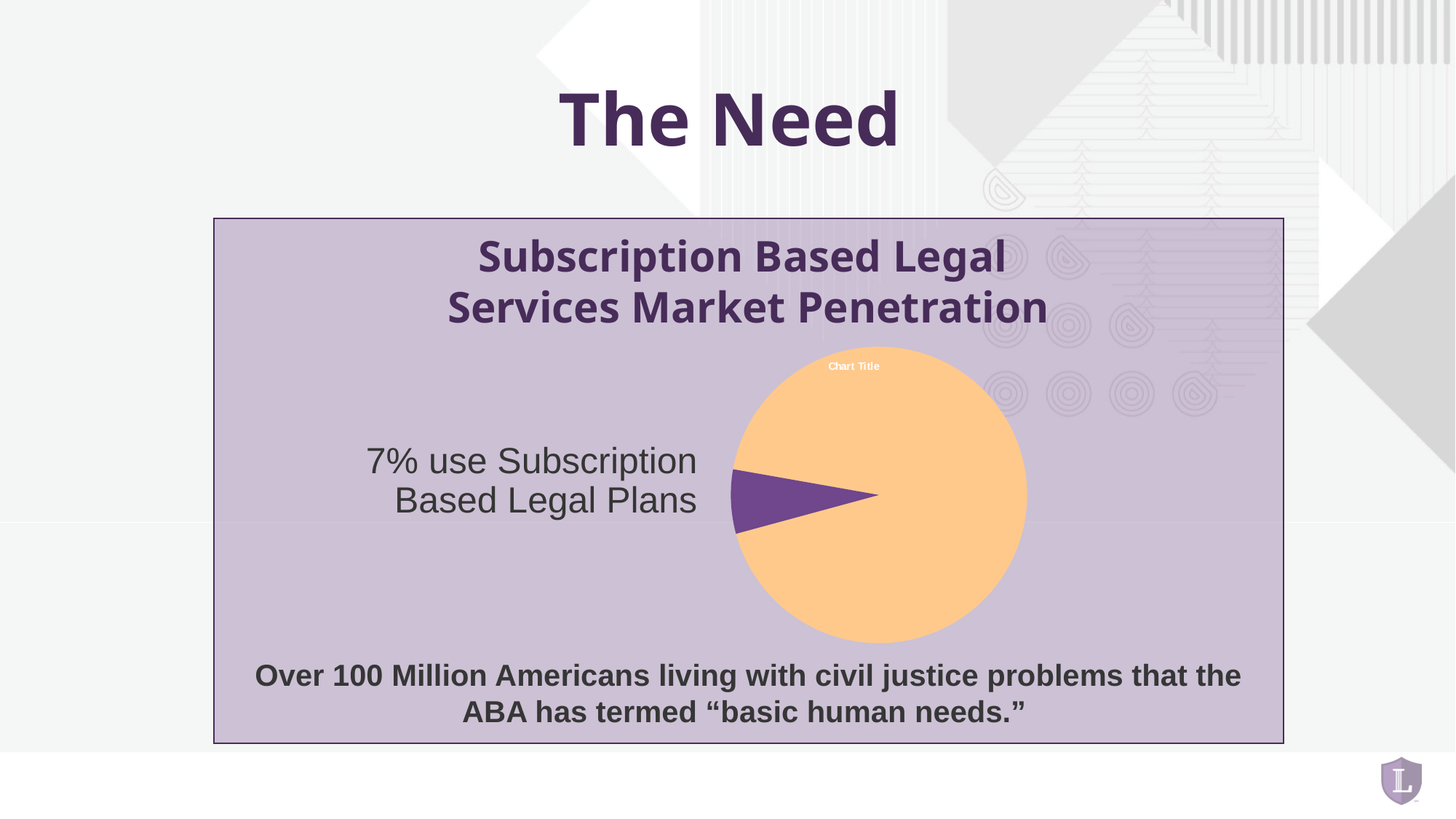
What placeholder title text is printed at the top of the pie chart? Chart Title How many slices does the pie chart have? 2 What colour is the slice representing people who use Subscription Based Legal Plans? purple Is the share of the purple slice greater or less than 50%? less What percentage of people use Subscription Based Legal Plans according to the slide? 7% What kind of chart is shown on the slide? pie chart Which slice of the pie chart is larger, the orange slice or the purple slice? the orange slice Is the share of the orange slice greater or less than 50%? greater What share of the pie does the small purple slice represent? 7%